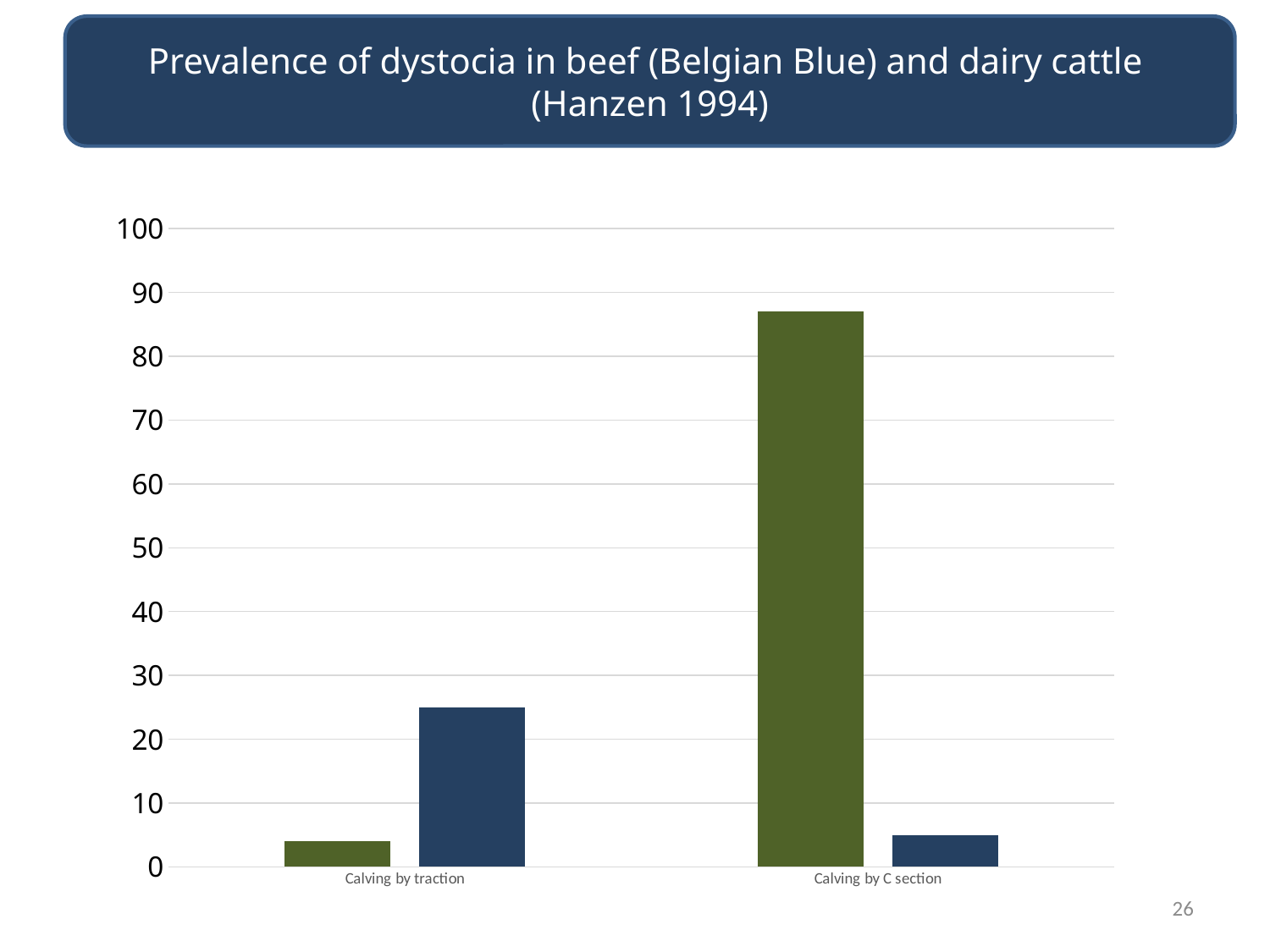
Is the value of the green bar for Calving by traction greater or less than 10? less What is the title shown at the top of the slide? Prevalence of dystocia in beef (Belgian Blue) and dairy cattle (Hanzen 1994) What kind of chart is shown on the slide? bar chart Is the value of the blue bar for Calving by traction greater or less than 30? less Is the value of the green bar for Calving by C section greater or less than 80? greater How many bars are plotted in total on the chart? 4 For Calving by C section, which bar is taller, the green one or the blue one? the green one Which category contains the tallest bar on the chart? Calving by C section For Calving by traction, which bar is taller, the green one or the blue one? the blue one How many categories are shown on the x axis of the chart? 2